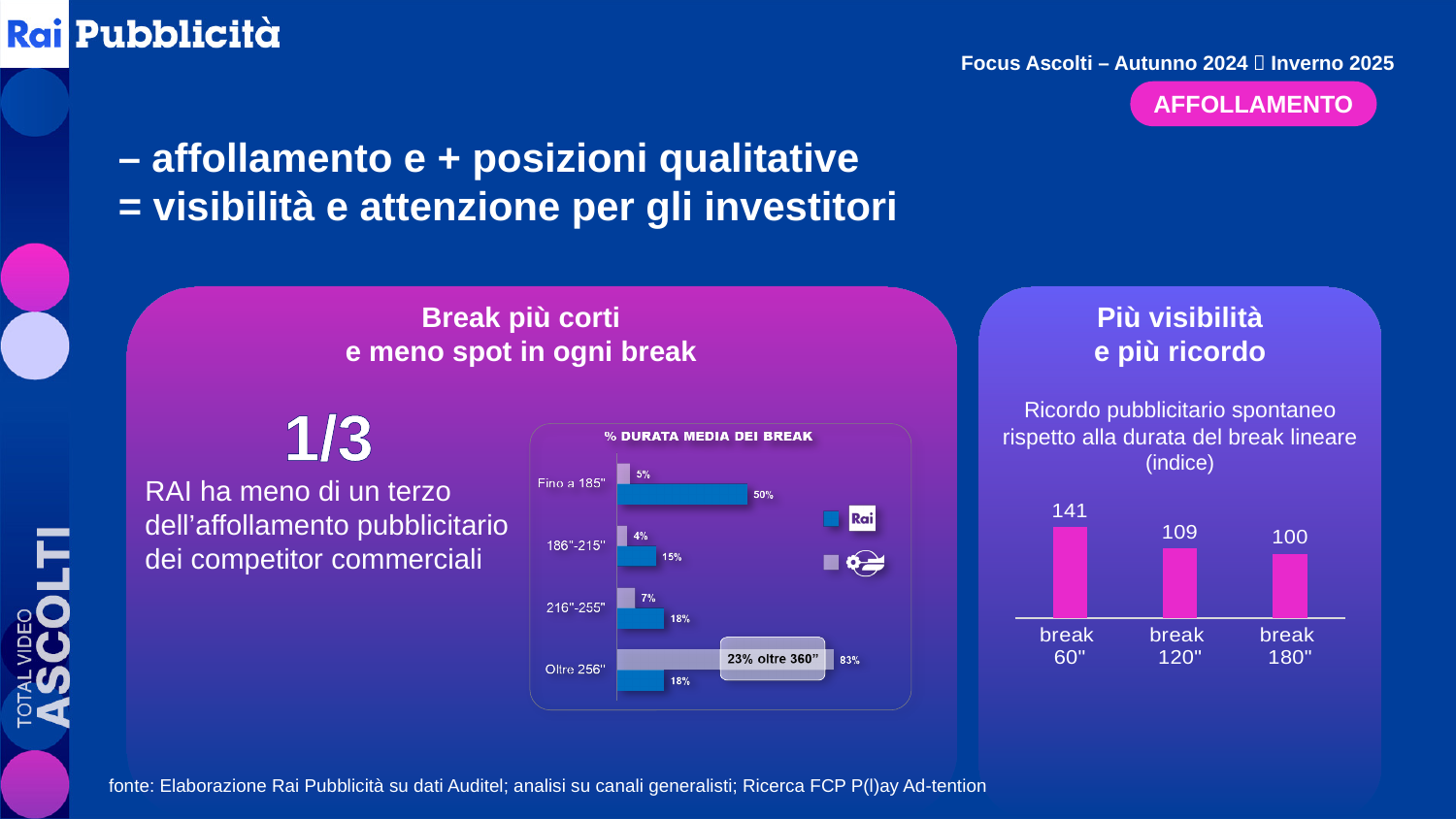
In the '% DURATA MEDIA DEI BREAK' chart, what is the value of the blue bar for 'Fino a 185"'? 50% How many categories are shown on the vertical axis of the '% DURATA MEDIA DEI BREAK' chart? 4 In the chart titled 'Ricordo pubblicitario spontaneo rispetto alla durata del break lineare (indice)', which break duration has the lowest value? break 180" In the chart titled 'Ricordo pubblicitario spontaneo rispetto alla durata del break lineare (indice)', what is the value for break 120"? 109 In the chart titled 'Ricordo pubblicitario spontaneo rispetto alla durata del break lineare (indice)', what is the value for break 60"? 141 In the '% DURATA MEDIA DEI BREAK' chart, what is the value of the blue bar for '186"-215"'? 15% What kind of chart is the '% DURATA MEDIA DEI BREAK' chart? bar chart In the chart titled 'Ricordo pubblicitario spontaneo rispetto alla durata del break lineare (indice)', do the values rise or fall as the break duration increases? fall In the chart titled 'Ricordo pubblicitario spontaneo rispetto alla durata del break lineare (indice)', what is the difference between the values for break 60" and break 180"? 41 How many bars are shown in the chart titled 'Ricordo pubblicitario spontaneo rispetto alla durata del break lineare (indice)'? 3 In the '% DURATA MEDIA DEI BREAK' chart, what is the value of the grey bar for 'Oltre 256"'? 83% In the chart titled 'Ricordo pubblicitario spontaneo rispetto alla durata del break lineare (indice)', which break duration has the highest value? break 60"